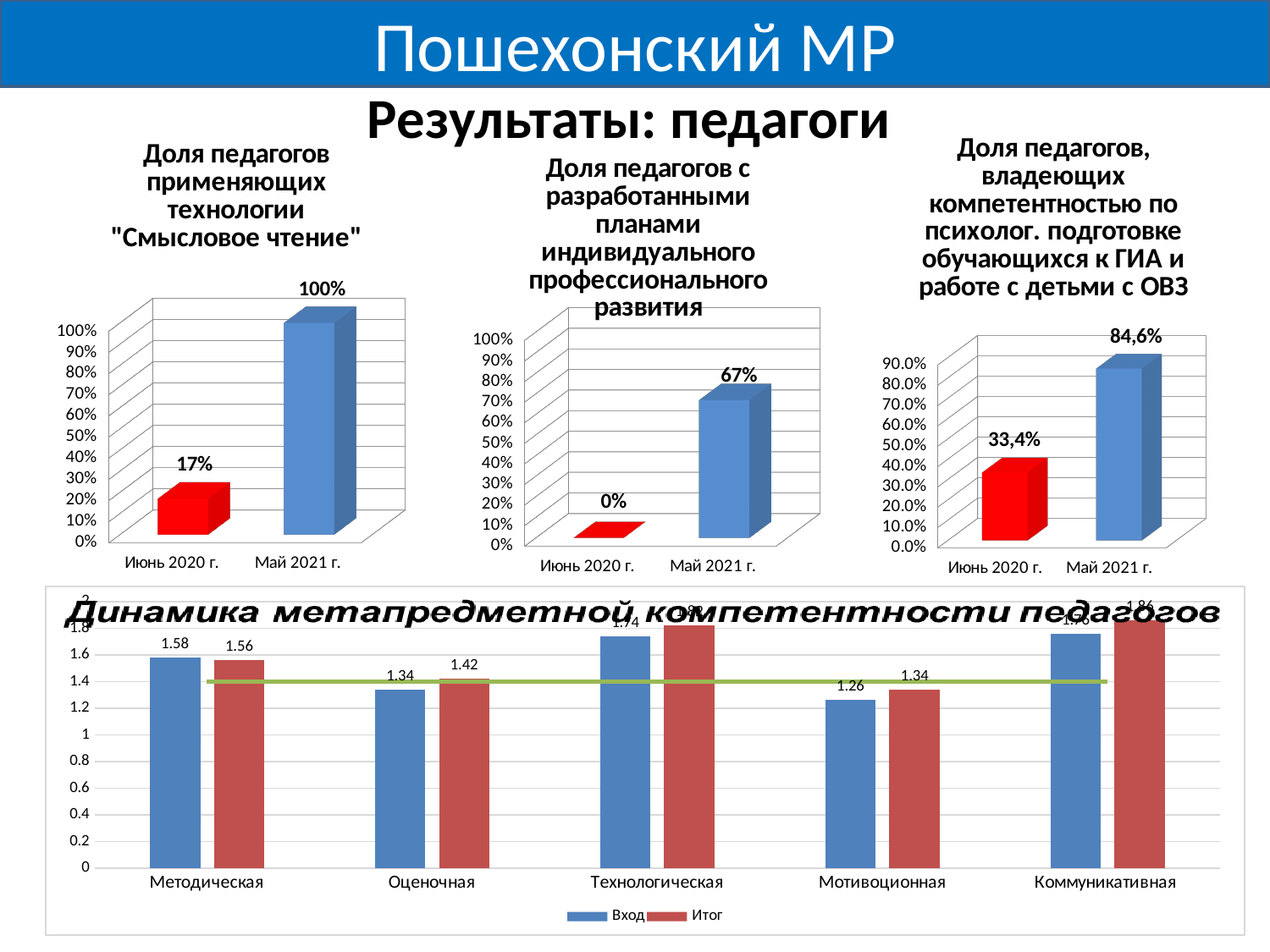
In the chart 'Динамика метапредметной компетентности педагогов', what is the Вход value for Методическая? 1.58 In the chart 'Динамика метапредметной компетентности педагогов', which category has the lowest Вход value? Мотивоционная How many series does the legend of the chart 'Динамика метапредметной компетентности педагогов' list? 2 In the chart 'Доля педагогов с разработанными планами индивидуального профессионального развития', what is the value for Май 2021 г.? 67% In the chart 'Доля педагогов применяющих технологии "Смысловое чтение"', what is the value for Июнь 2020 г.? 17% In the chart 'Доля педагогов применяющих технологии "Смысловое чтение"', do the values rise or fall from Июнь 2020 г. to Май 2021 г.? rise How many categories are shown on the x axis of the chart 'Динамика метапредметной компетентности педагогов'? 5 In the chart 'Доля педагогов с разработанными планами индивидуального профессионального развития', what is the value for Июнь 2020 г.? 0% In the top-right chart about психолог. подготовке обучающихся к ГИА, what is the value for Июнь 2020 г.? 33,4% In the chart 'Динамика метапредметной компетентности педагогов', what is the Итог value for Оценочная? 1.42 In the top-right chart about психолог. подготовке обучающихся к ГИА, what is the difference between Май 2021 г. and Июнь 2020 г.? 51,2% In the chart 'Доля педагогов применяющих технологии "Смысловое чтение"', what is the value for Май 2021 г.? 100%